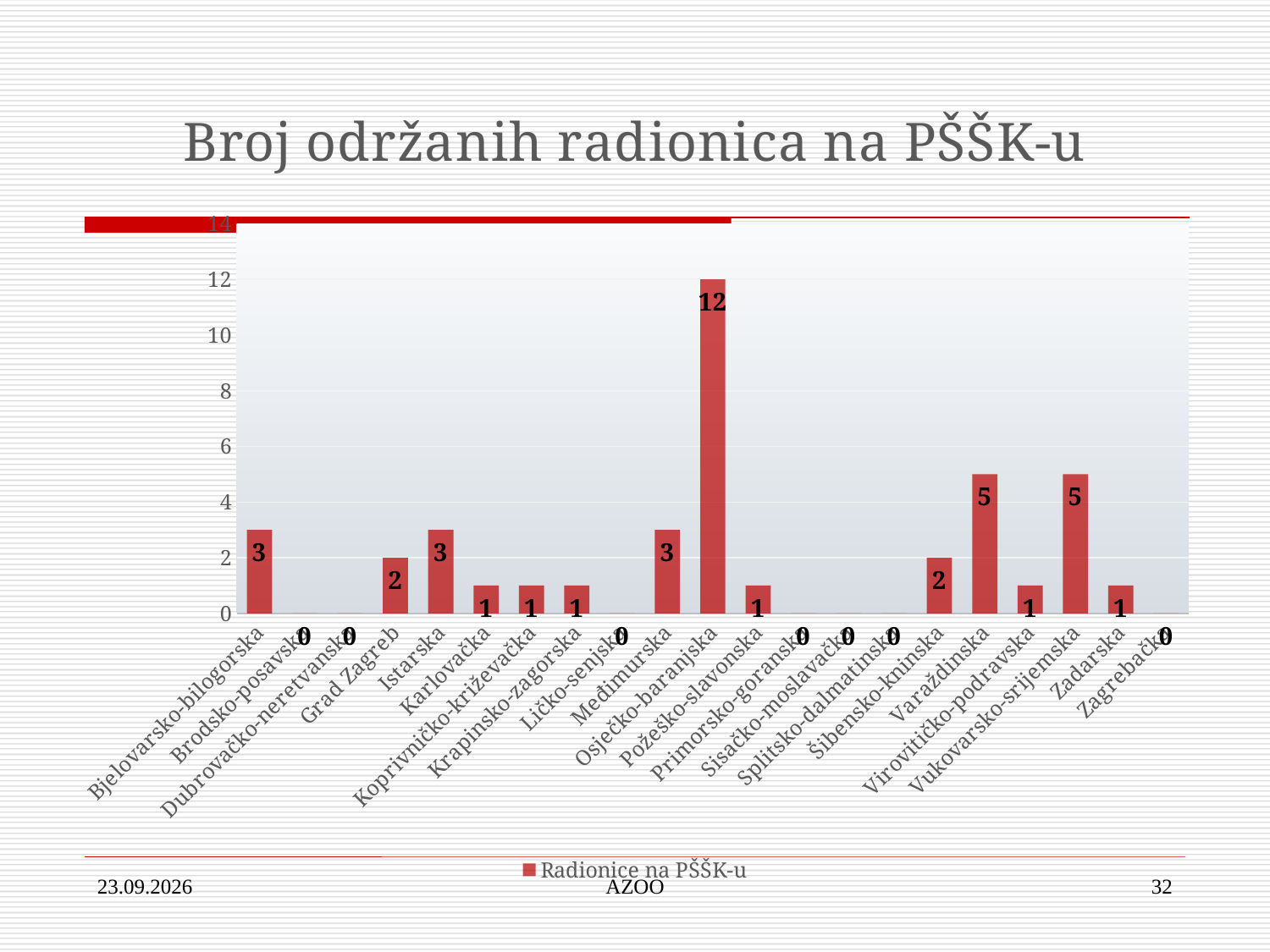
What kind of chart is shown on the slide? bar chart Which category has the highest value? Osječko-baranjska What is the difference between the values for Osječko-baranjska and Vukovarsko-srijemska? 7 Is the value for Osječko-baranjska greater or less than 10? greater Which is larger, the value for Međimurska or the value for Šibensko-kninska? Međimurska What is the value for Brodsko-posavska? 0 How many series does the legend list? 1 What is the value for Osječko-baranjska? 12 What is the value for Grad Zagreb? 2 What is the value for Varaždinska? 5 What is the difference between the values for Istarska and Karlovačka? 2 How many categories are shown on the x axis? 21